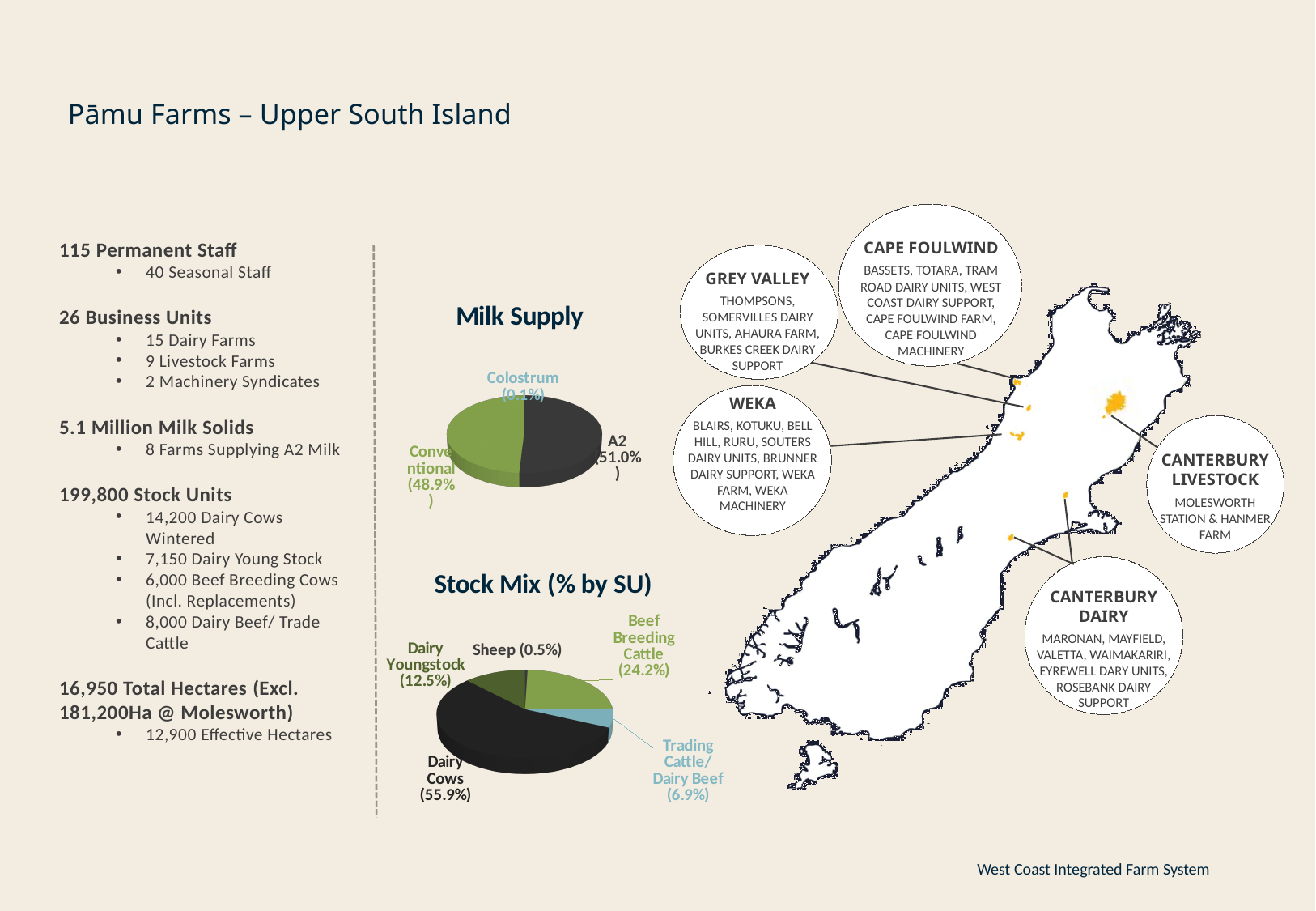
On the Milk Supply chart, what share of milk supply is Conventional? 48.9% On the Milk Supply chart, which category has the smallest share? Colostrum On the Stock Mix (% by SU) chart, what is the difference between the Dairy Youngstock share and the Trading Cattle/Dairy Beef share? 5.6% On the Stock Mix (% by SU) chart, what share do Dairy Cows make up? 55.9% On the Milk Supply chart, what share of milk supply is A2? 51.0% On the Stock Mix (% by SU) chart, which category has the smallest share? Sheep On the Stock Mix (% by SU) chart, how many categories are shown? 5 On the Stock Mix (% by SU) chart, which category has the largest share? Dairy Cows On the Stock Mix (% by SU) chart, what share do Beef Breeding Cattle make up? 24.2% On the Milk Supply chart, what share of milk supply is Colostrum? 0.1% What kind of chart is the Stock Mix (% by SU) chart? Pie chart On the Milk Supply chart, how many categories are shown? 3